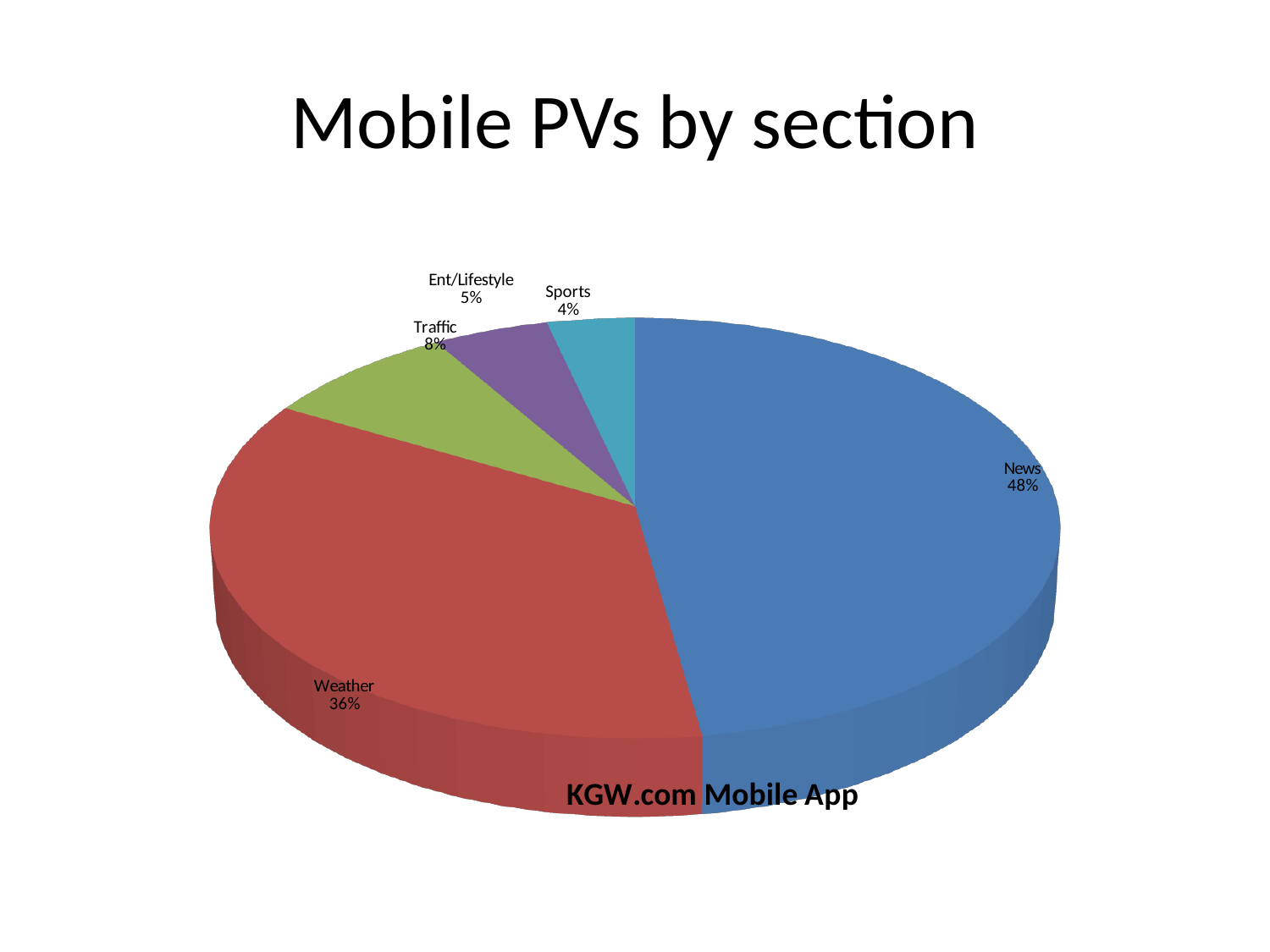
What colour is the Weather slice? Red Which section has the largest share of mobile PVs? News What is the difference in percentage points between the News and Weather shares? 12 What share of mobile PVs does the Weather section have? 36% What type of chart is shown on the slide? Pie chart What share of mobile PVs does the Traffic section have? 8% What share of mobile PVs does the News section have? 48% What share of mobile PVs does the Sports section have? 4% Which section has the smallest share of mobile PVs? Sports Which has a larger share, Traffic or Ent/Lifestyle? Traffic What is the title of the chart? KGW.com Mobile App How many sections are shown in the pie chart? 5